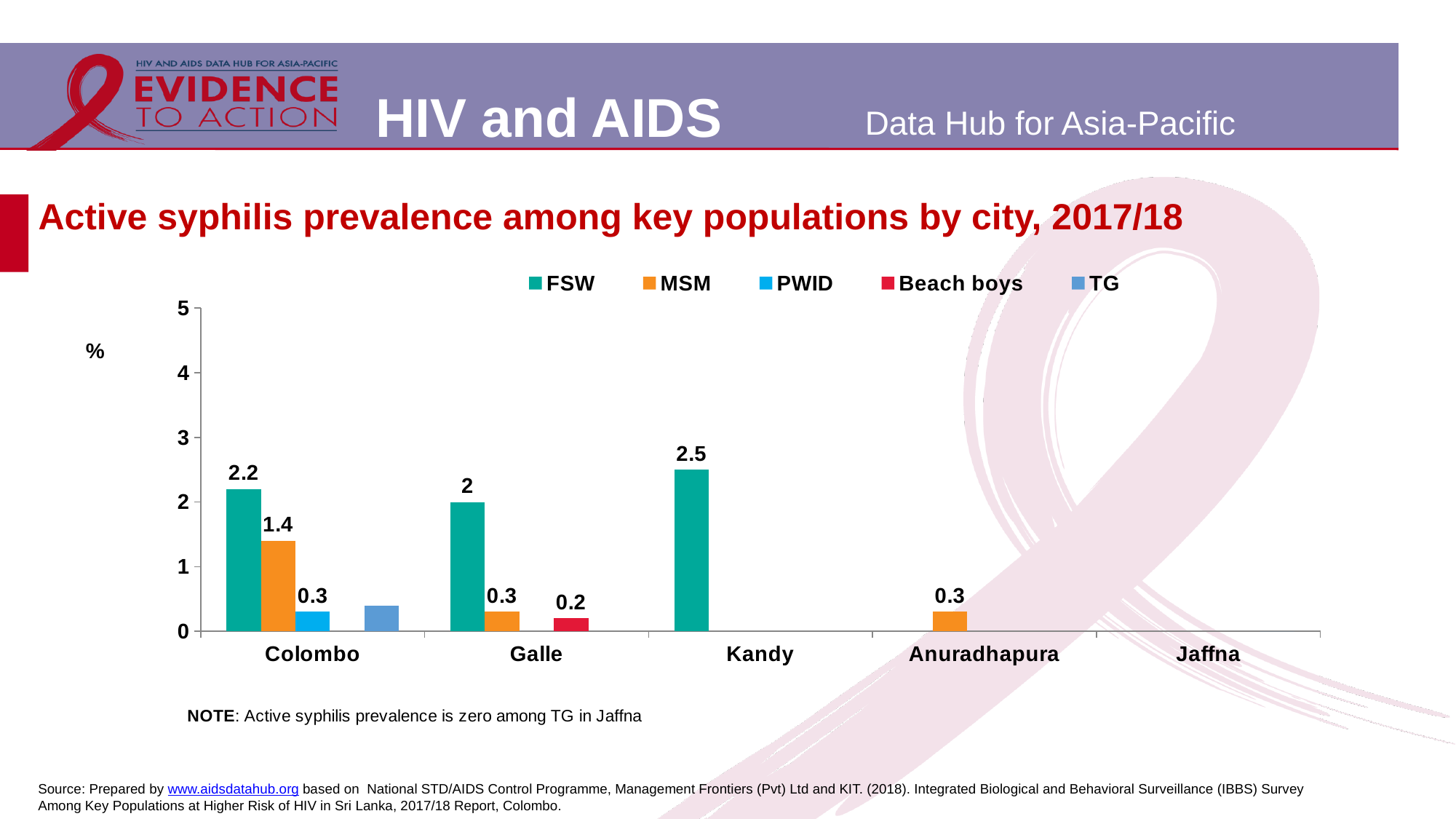
How many series does the legend list? 5 What is the active syphilis prevalence among Beach boys in Galle? 0.2 What is the active syphilis prevalence among FSW in Kandy? 2.5 Which city has the highest active syphilis prevalence among FSW? Kandy What is the active syphilis prevalence among MSM in Colombo? 1.4 What kind of chart is shown on the slide? bar chart Is the value for TG in Colombo greater or less than 1? less What is the active syphilis prevalence among FSW in Colombo? 2.2 How many cities are shown on the x axis of the chart? 5 What is the difference between the FSW and MSM active syphilis prevalence in Colombo? 0.8 What is the title of the chart? Active syphilis prevalence among key populations by city, 2017/18 Which is larger: the FSW prevalence in Colombo or the FSW prevalence in Galle? Colombo